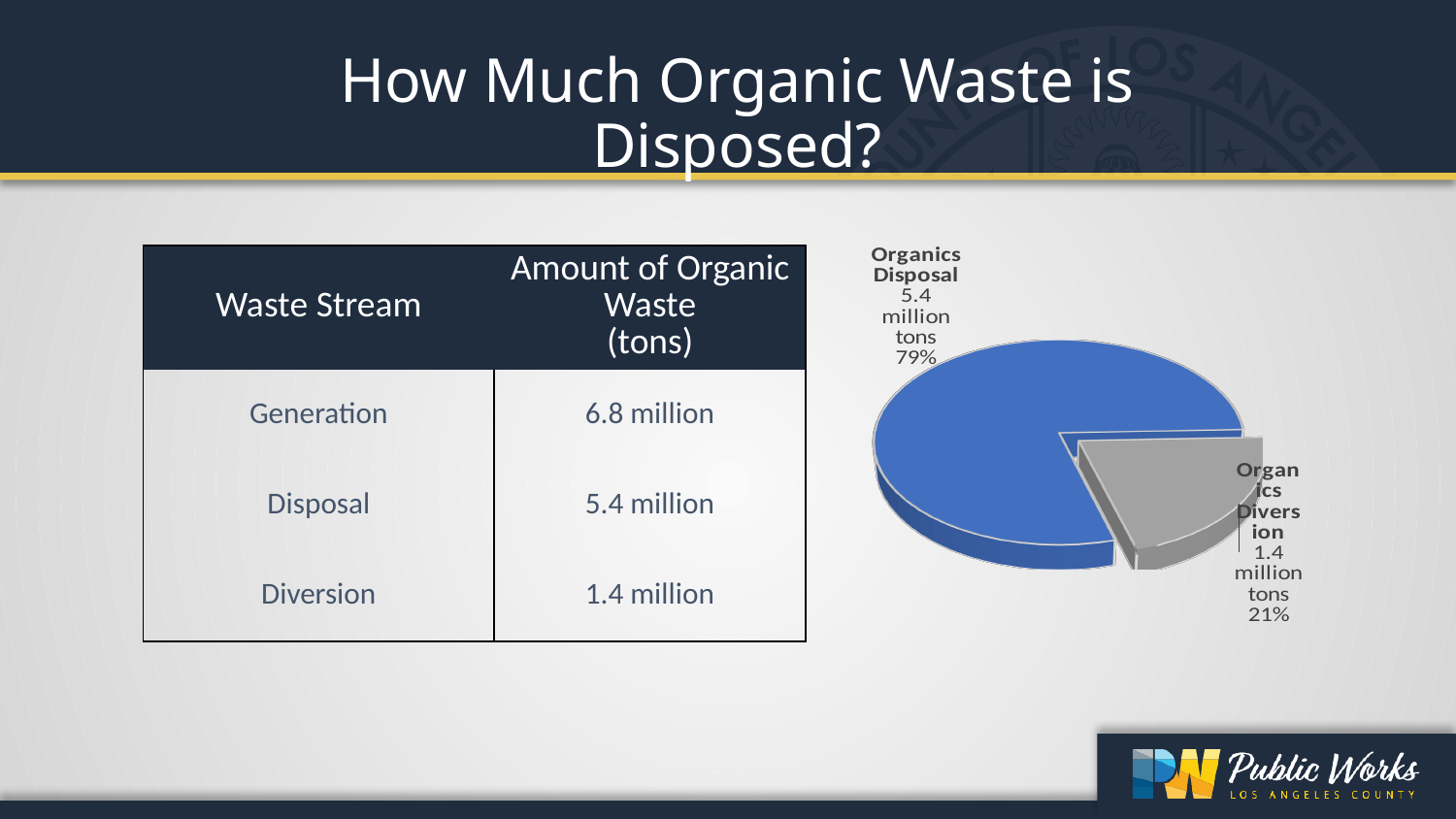
Which is larger in the pie chart, Organics Disposal or Organics Diversion? Organics Disposal What is the value labelled for Organics Diversion in the pie chart? 1.4 million tons What is the difference in percentage points between the Organics Disposal and Organics Diversion slices? 58 percentage points What share of the pie does Organics Diversion represent? 21% What colour is the Organics Disposal slice in the pie chart? Blue What is the value labelled for Organics Disposal in the pie chart? 5.4 million tons What kind of chart is shown on the slide? Pie chart How many slices does the pie chart have? 2 Which slice of the pie chart is the largest? Organics Disposal What colour is the Organics Diversion slice in the pie chart? Grey What share of the pie does Organics Disposal represent? 79% Which slice of the pie chart is the smallest? Organics Diversion